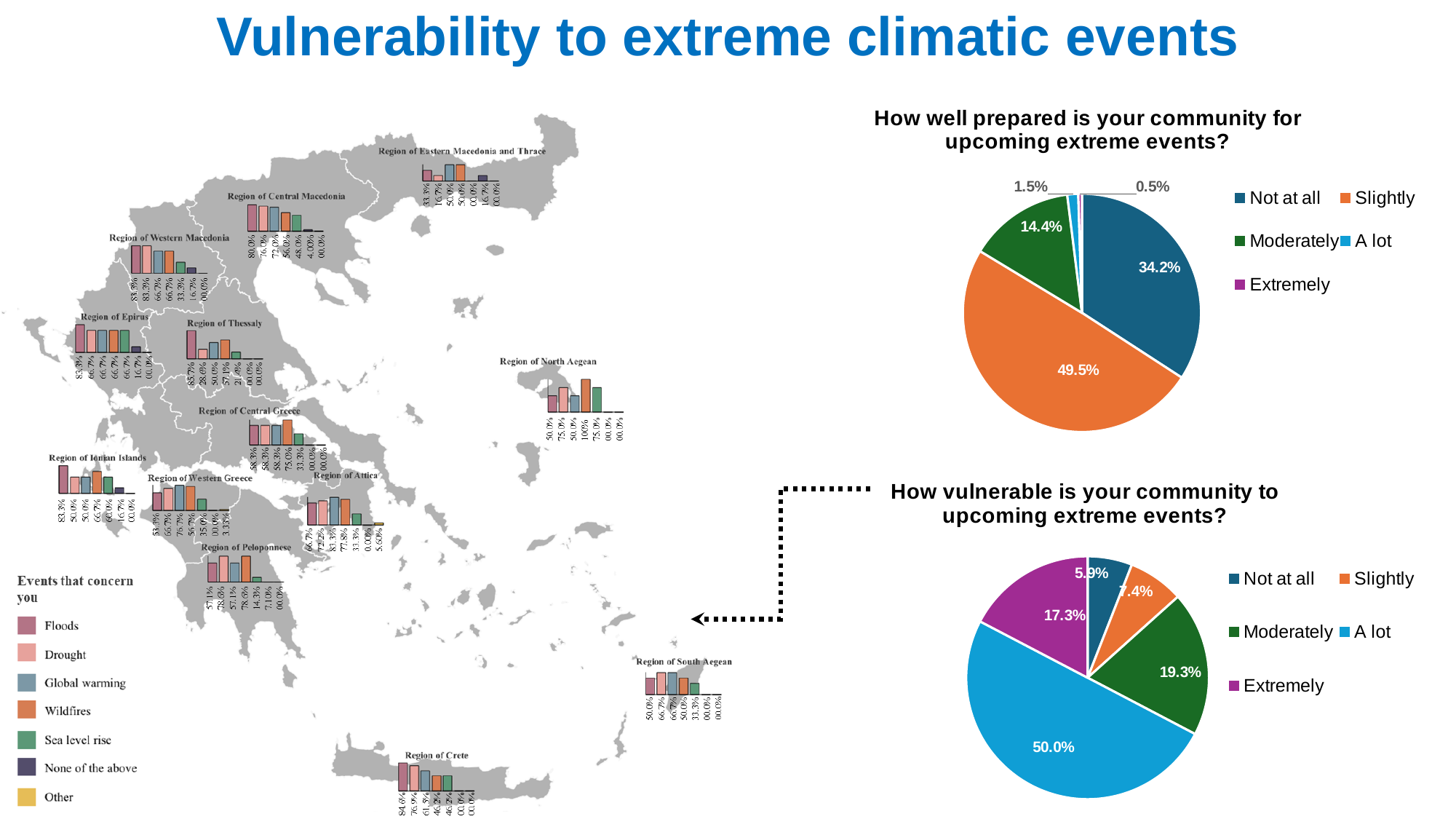
How many categories does the legend of the pie chart 'How well prepared is your community for upcoming extreme events?' list? 5 In the pie chart 'How vulnerable is your community to upcoming extreme events?', what share of respondents answered 'A lot'? 50.0% What type of chart is used for 'How vulnerable is your community to upcoming extreme events?' Pie chart In the pie chart 'How vulnerable is your community to upcoming extreme events?', what share of respondents answered 'Moderately'? 19.3% In the pie chart 'How well prepared is your community for upcoming extreme events?', which response has the largest share? Slightly In the pie chart 'How well prepared is your community for upcoming extreme events?', what is the difference between the 'Slightly' and 'Not at all' shares? 15.3% In the pie chart 'How well prepared is your community for upcoming extreme events?', which response has the smallest share? Extremely In the pie chart 'How vulnerable is your community to upcoming extreme events?', which is larger: the 'Extremely' share or the 'Slightly' share? Extremely In the pie chart 'How vulnerable is your community to upcoming extreme events?', which response has the largest share? A lot In the pie chart 'How well prepared is your community for upcoming extreme events?', what share of respondents answered 'Not at all'? 34.2% In the pie chart 'How well prepared is your community for upcoming extreme events?', what share of respondents answered 'Slightly'? 49.5% In the pie chart 'How vulnerable is your community to upcoming extreme events?', what is the difference between the 'Moderately' and 'Extremely' shares? 2.0%